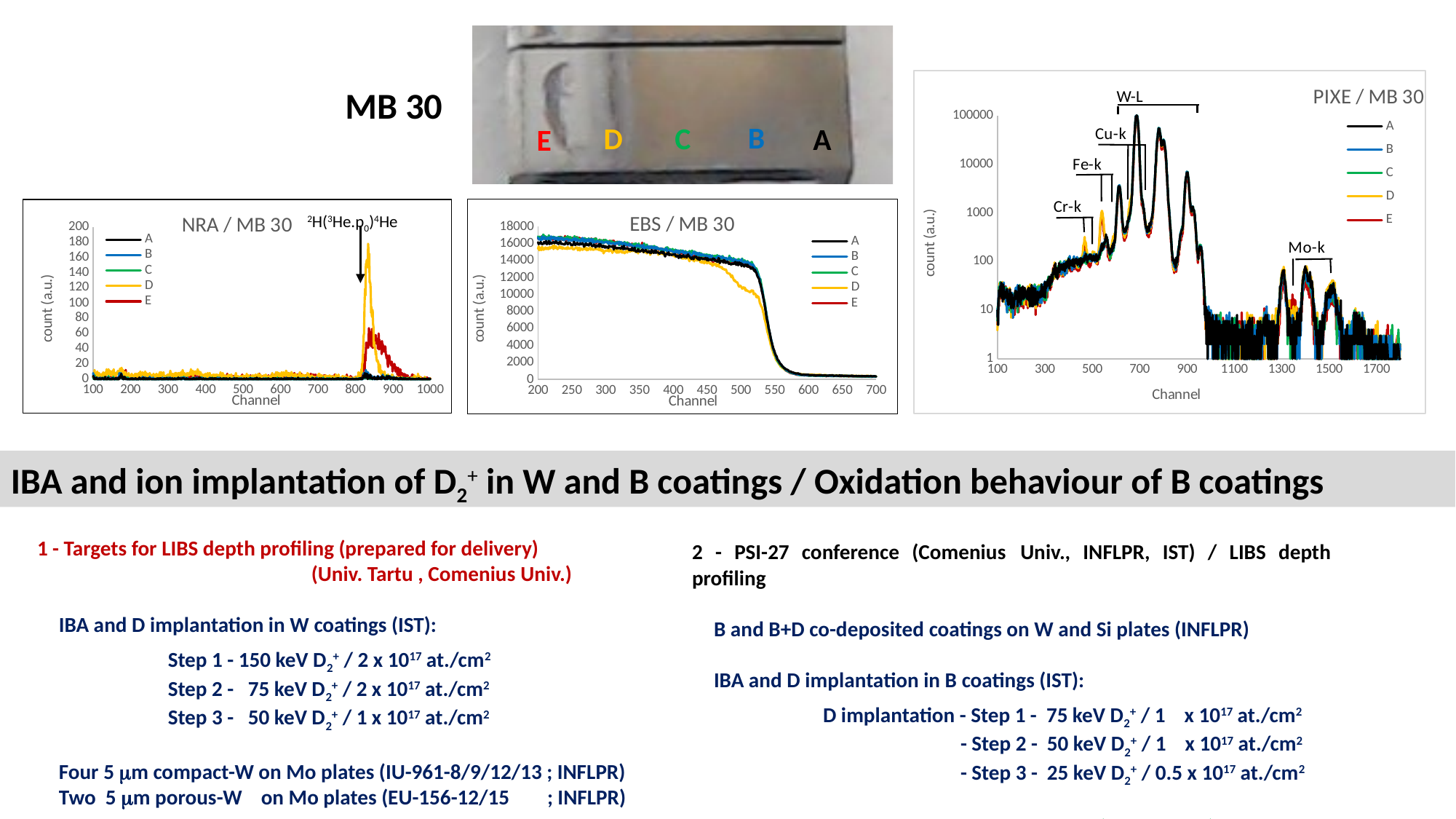
What kind of chart is the NRA / MB 30 chart? line chart In the EBS / MB 30 chart, which series has the lowest value around channel 500? D In the EBS / MB 30 chart, is the value of series A at channel 250 greater or less than 14000? greater What is the highest tick value shown on the y axis of the PIXE / MB 30 chart? 100000 In the EBS / MB 30 chart, do the values rise or fall as the channel increases from 200 to 700? fall How many series does the legend of the NRA / MB 30 chart list? 5 In the PIXE / MB 30 chart, is the W-L peak greater or less than 10000 counts? greater In the NRA / MB 30 chart, which series has the highest peak? D What is the label of the y axis on the PIXE / MB 30 chart? count (a.u.) In the EBS / MB 30 chart, is the value of series A at channel 650 greater or less than 2000? less